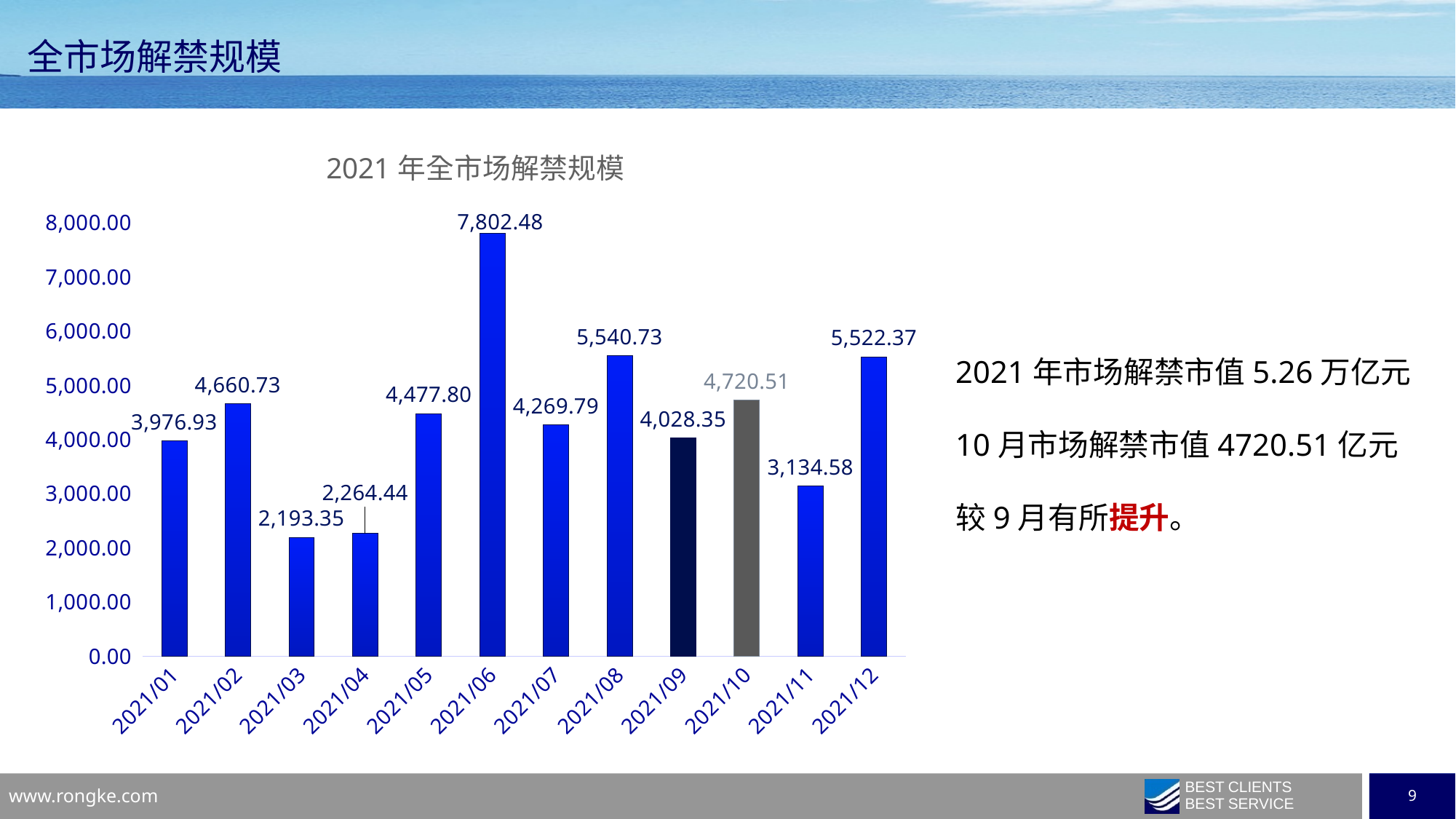
What is the value for 2021/10 in the chart? 4,720.51 What is the title of the chart? 2021 年全市场解禁规模 How many months are plotted in the chart? 12 What is the value for 2021/06 in the chart? 7,802.48 Which is larger, the value for 2021/08 or the value for 2021/12? 2021/08 What is the value for 2021/03 in the chart? 2,193.35 Which month has the lowest value in the chart? 2021/03 Which month has the highest value in the chart? 2021/06 What kind of chart is shown on the slide? Bar chart Does the value rise or fall from 2021/09 to 2021/10? Rise What is the difference between the values for 2021/10 and 2021/09? 692.16 What is the difference between the values for 2021/06 and 2021/03? 5,609.13